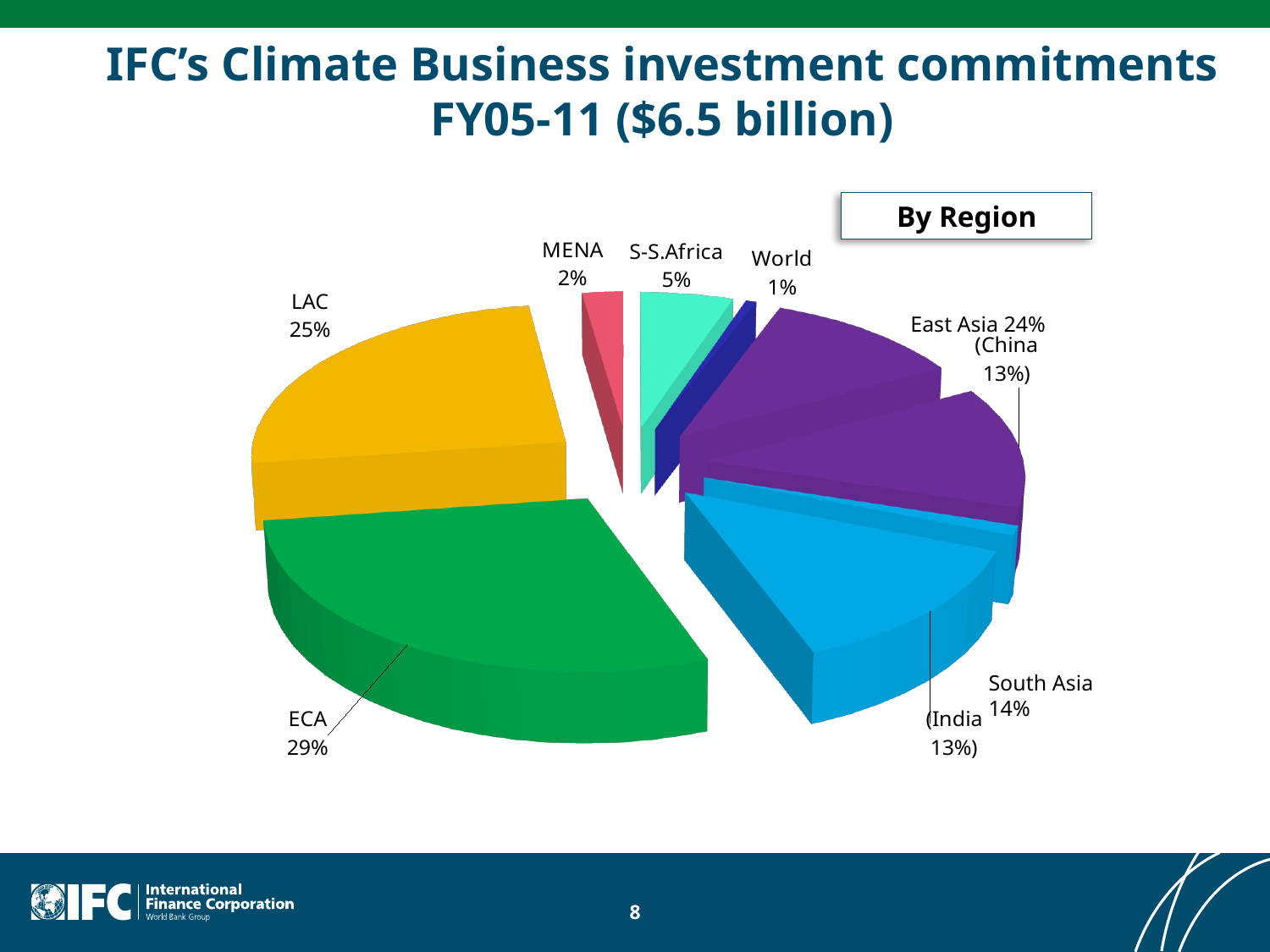
What share of the commitments went to South Asia? 14% What share of the commitments went to China? 13% How many percentage points larger is ECA's share than LAC's share? 4% What share of the commitments is labelled World? 1% Which region has the largest share of the commitments? ECA What total amount of commitments does the chart title state for FY05-11? $6.5 billion What kind of chart is shown on the slide? Pie chart Which labelled category has the smallest share of the commitments? World What share of the commitments went to MENA? 2% What share of the commitments went to LAC? 25% What share of the commitments went to East Asia? 24% What share of IFC's Climate Business investment commitments went to ECA? 29%